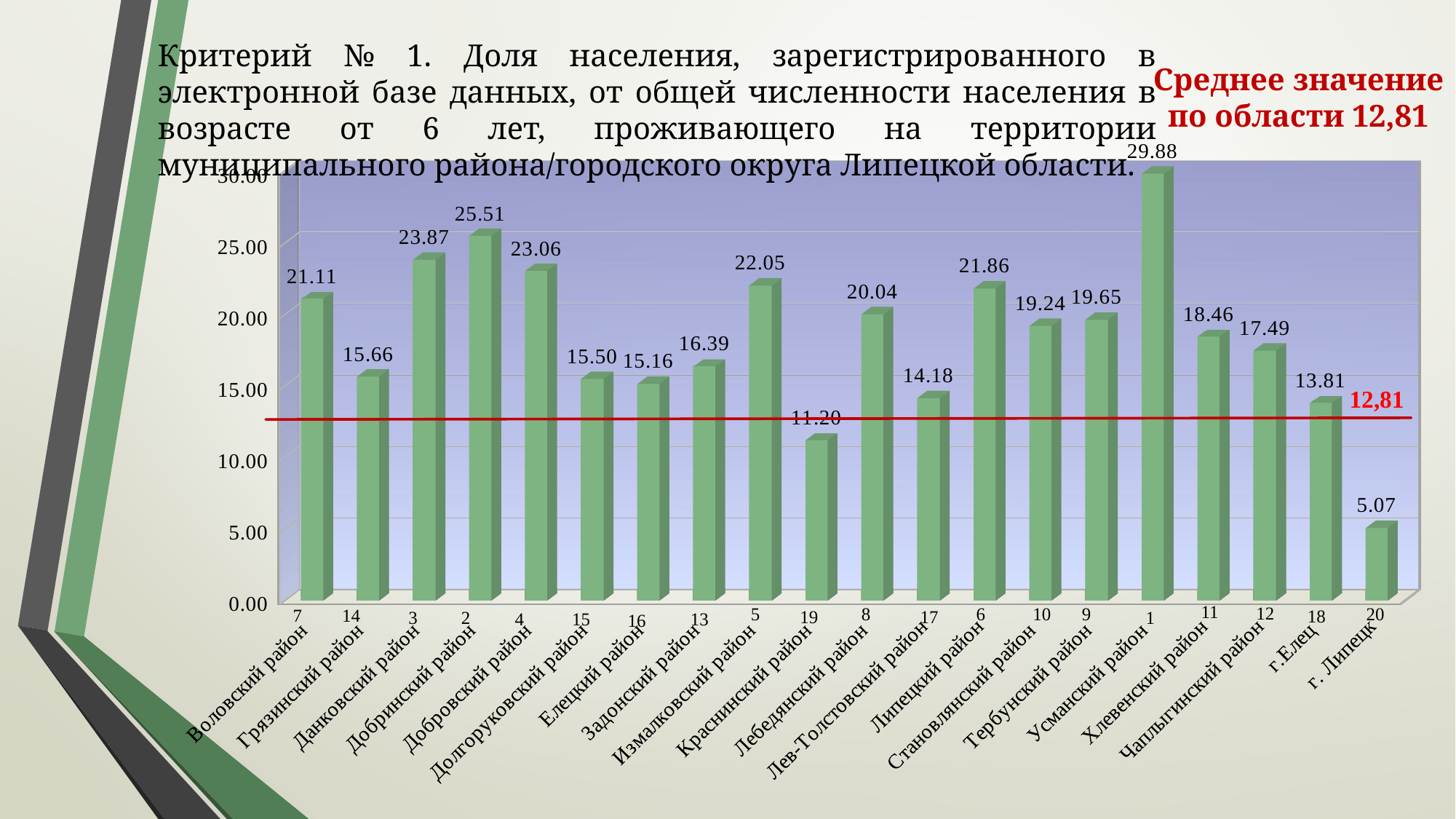
Which district has the highest value? Усманский район Which is larger, the value for Измалковский район or the value for Липецкий район? Измалковский район What kind of chart is shown on the slide? bar chart Is the value for Лев-Толстовский район greater or less than 15.00? less How many districts/cities are shown on the chart? 20 What is the value for Чаплыгинский район? 17.49 What is the value for Краснинский район? 11.20 What is the difference between the values for Добринский район and Данковский район? 1.64 What is the regional average value marked by the red line on the chart? 12,81 What is the value for г. Липецк? 5.07 Which category has the lowest value? г. Липецк What is the value for Усманский район? 29.88